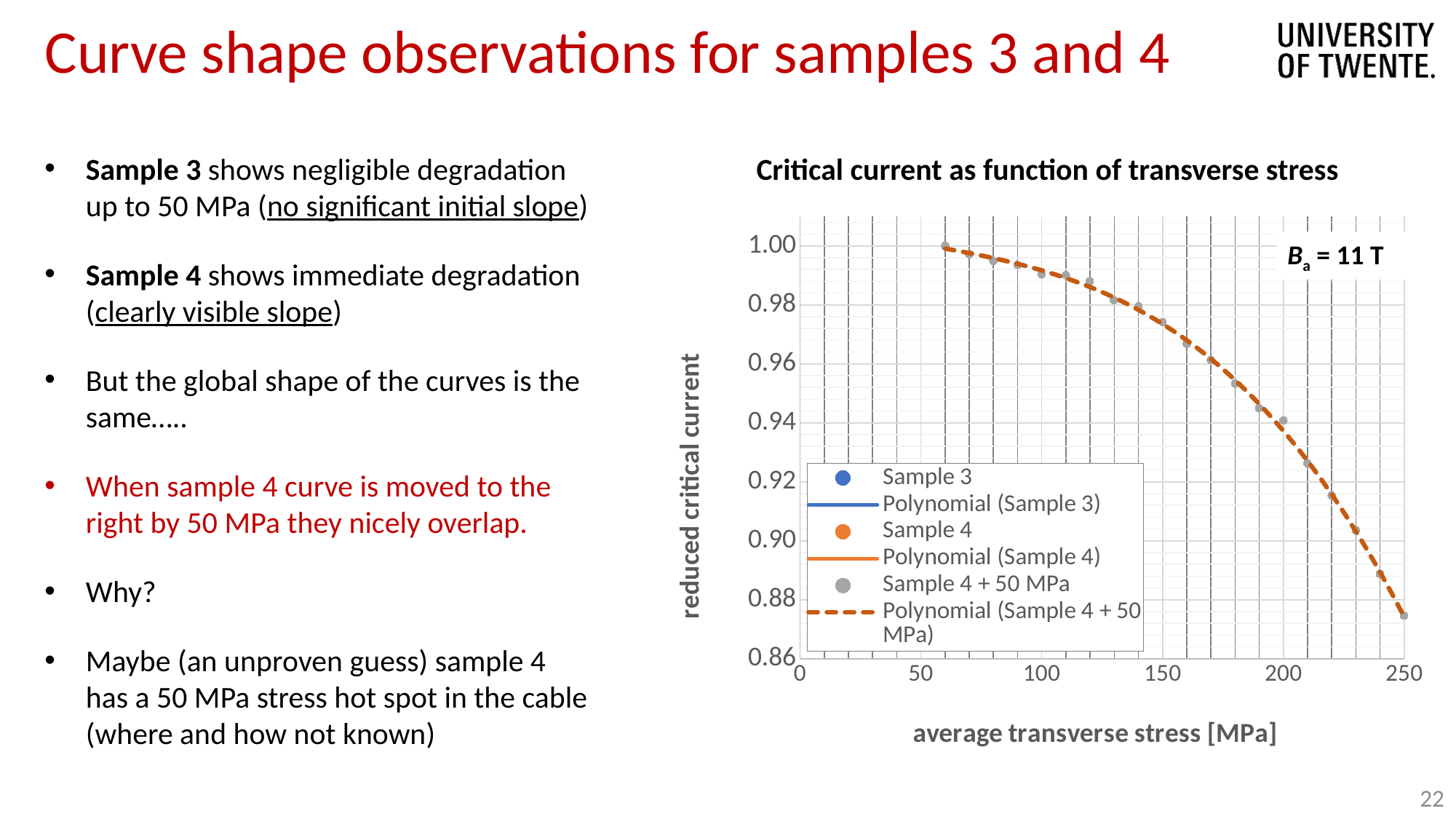
Do the plotted values rise or fall as the average transverse stress increases? fall Is the reduced critical current at 250 MPa greater or less than 0.88? less Which is larger, the reduced critical current at 100 MPa or at 200 MPa? 100 MPa Is the reduced critical current at 100 MPa greater or less than 0.98? greater What kind of chart is shown on the slide? Scatter chart with polynomial trend lines At which average transverse stress is the reduced critical current highest? 60 MPa Is the reduced critical current at 240 MPa greater or less than 0.90? less At which average transverse stress is the reduced critical current lowest? 250 MPa How many entries does the chart legend list? 6 What is the title of the chart? Critical current as function of transverse stress What is the label of the x axis of the chart? average transverse stress [MPa]